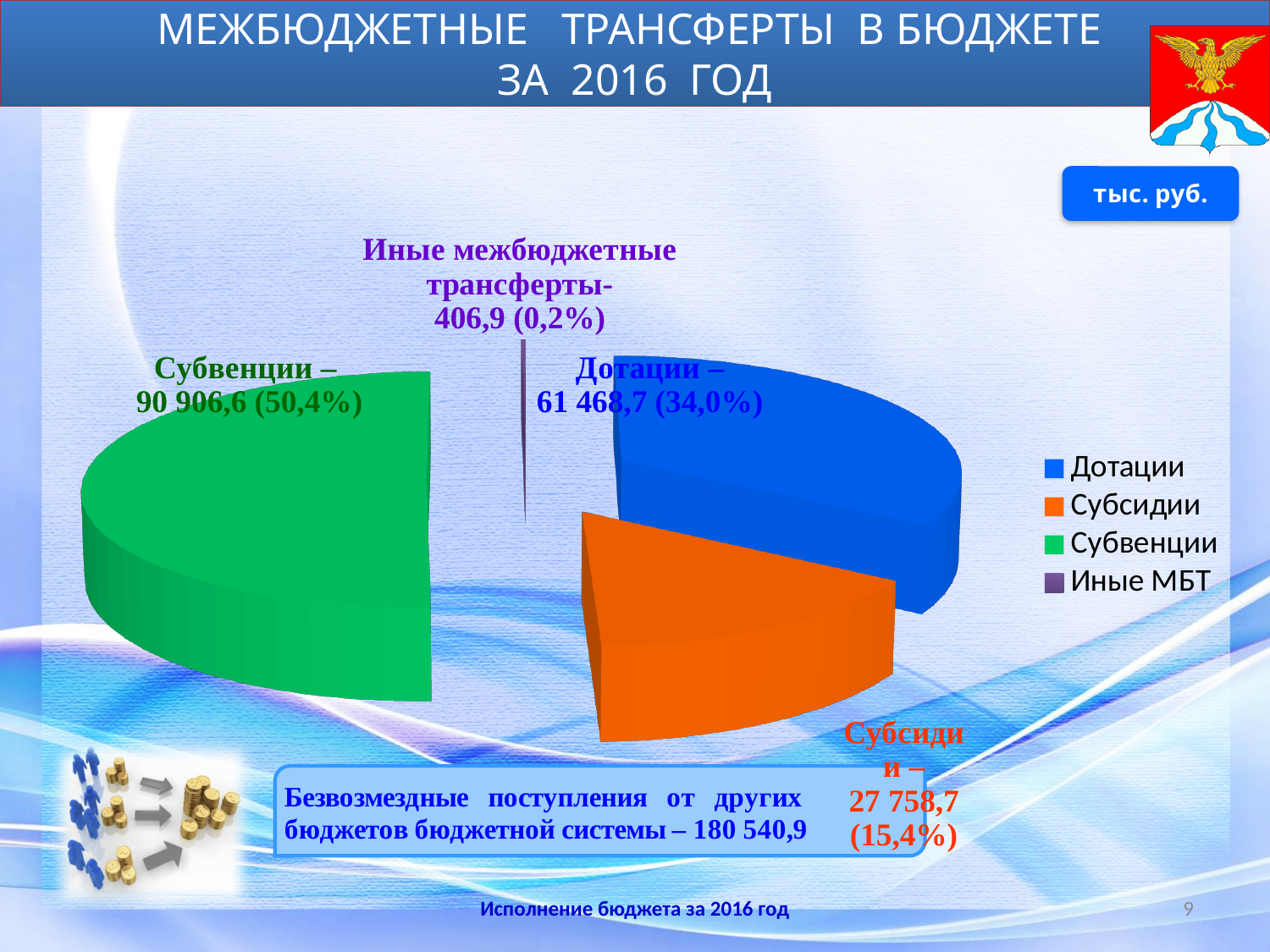
Which is larger, Дотации or Субсидии? Дотации What is the value for Субвенции? 90 906,6 What unit of measurement is indicated for the chart values? тыс. руб. What share of the pie does Субсидии represent? 15,4% What share of the pie does Дотации represent? 34,0% What is the value for Дотации? 61 468,7 Which category has the largest slice of the pie? Субвенции Which category has the smallest slice of the pie? Иные межбюджетные трансферты How many entries does the legend list? 4 What is the value for Иные межбюджетные трансферты? 406,9 What is the value for Субсидии? 27 758,7 What kind of chart is shown on the slide? pie chart